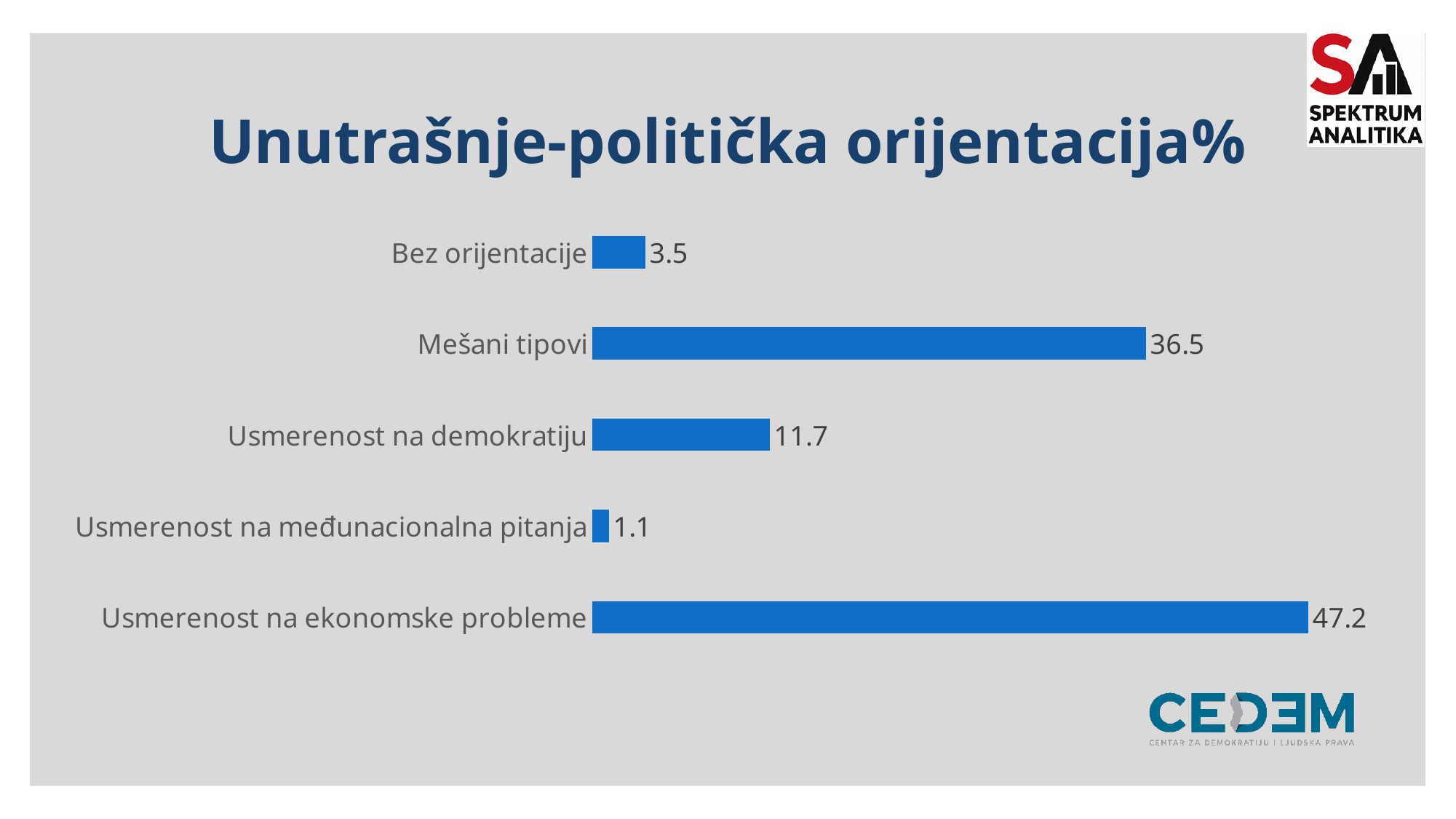
What kind of chart is shown on the slide? Bar chart How many categories are shown in the chart? 5 Which is larger, the value for Bez orijentacije or the value for Usmerenost na međunacionalna pitanja? Bez orijentacije What is the value for Bez orijentacije? 3.5 What is the value for Usmerenost na međunacionalna pitanja? 1.1 What is the value for Usmerenost na ekonomske probleme? 47.2 What is the difference between the values for Usmerenost na demokratiju and Bez orijentacije? 8.2 What is the difference between the values for Usmerenost na ekonomske probleme and Mešani tipovi? 10.7 Which category has the lowest value? Usmerenost na međunacionalna pitanja What is the value for Usmerenost na demokratiju? 11.7 Which category has the highest value? Usmerenost na ekonomske probleme What is the value for Mešani tipovi? 36.5